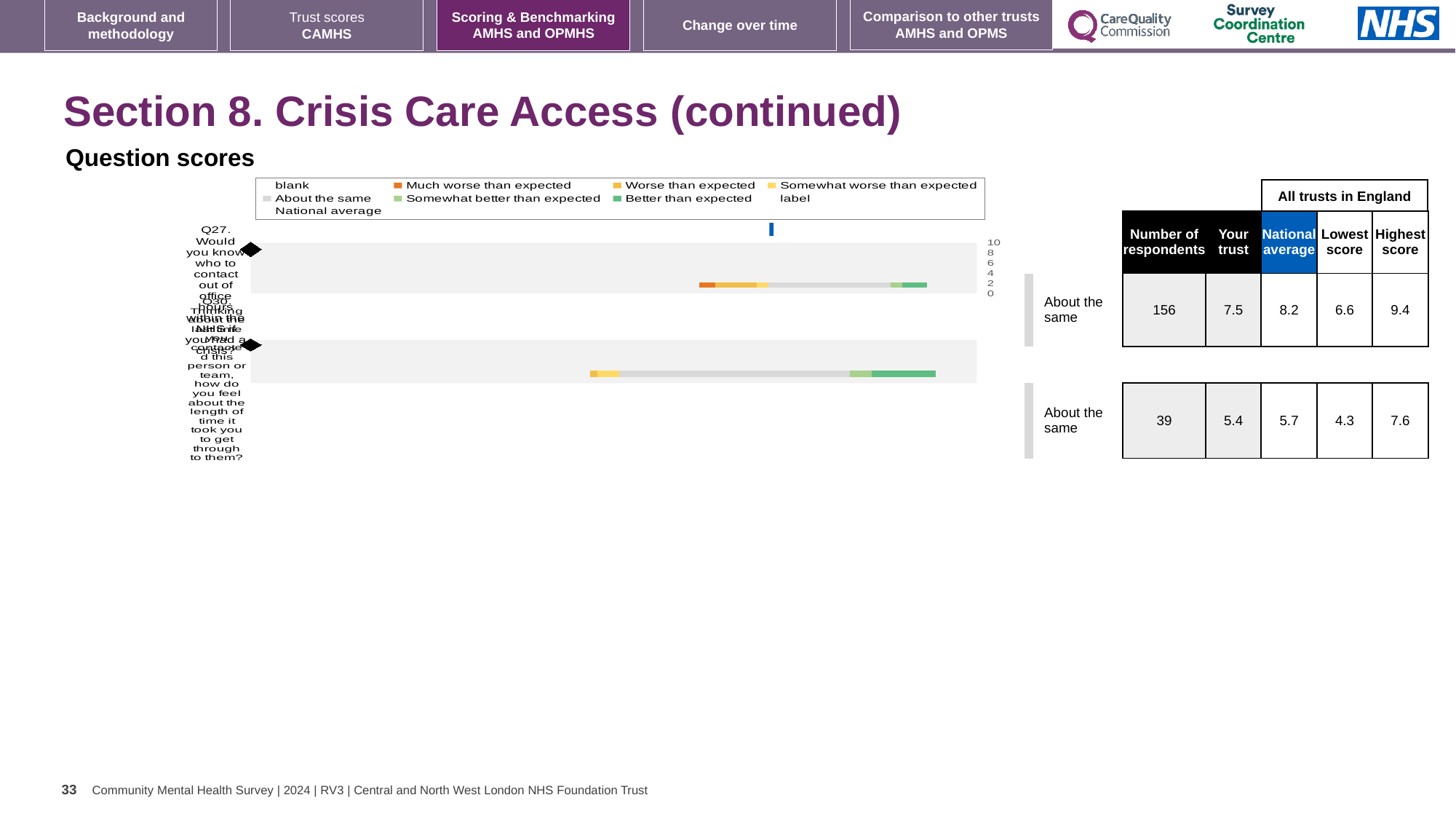
Which colour in the chart legend represents 'Much worse than expected'? orange In the table, how many respondents answered Q27? 156 In the table, what is the national average for Q30? 5.7 How many questions (rows) are plotted in the chart? 2 What kind of chart is shown under 'Question scores'? bar chart Which colour in the chart legend represents 'Better than expected'? green In the table, what is the lowest score among all trusts in England for Q30? 4.3 In the table, what is the 'Your trust' score for Q27? 7.5 What is the difference between the national average and the 'Your trust' score for Q27? 0.7 What benchmark category is shown next to the chart for Q30? About the same In the table, what is the highest score among all trusts in England for Q27? 9.4 Which question has the higher 'Your trust' score, Q27 or Q30? Q27